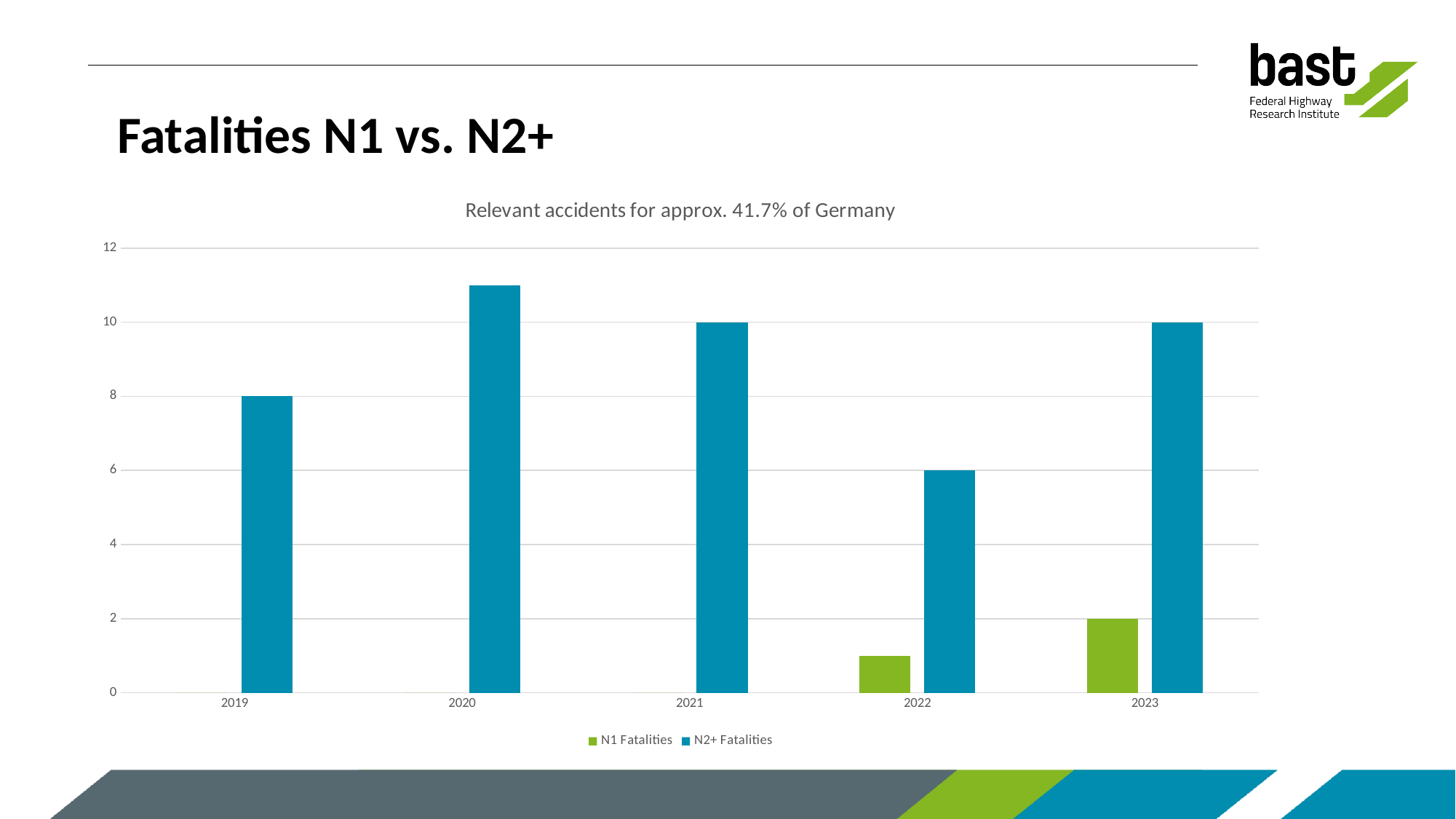
What type of chart is shown on the slide? Bar chart Which year has the lowest value for N2+ Fatalities? 2022 What is the value of N1 Fatalities for 2023? 2 Is the value for N1 Fatalities in 2022 greater or less than 2? less What is the difference between N2+ Fatalities in 2023 and in 2019? 2 Is the value for N2+ Fatalities in 2020 greater or less than 10? greater What is the value of N2+ Fatalities for 2019? 8 How many years are shown on the x axis? 5 Which year has the highest value for N2+ Fatalities? 2020 How many series does the legend list? 2 Which is larger: N2+ Fatalities in 2021 or in 2022? 2021 What is the value of N2+ Fatalities for 2022? 6